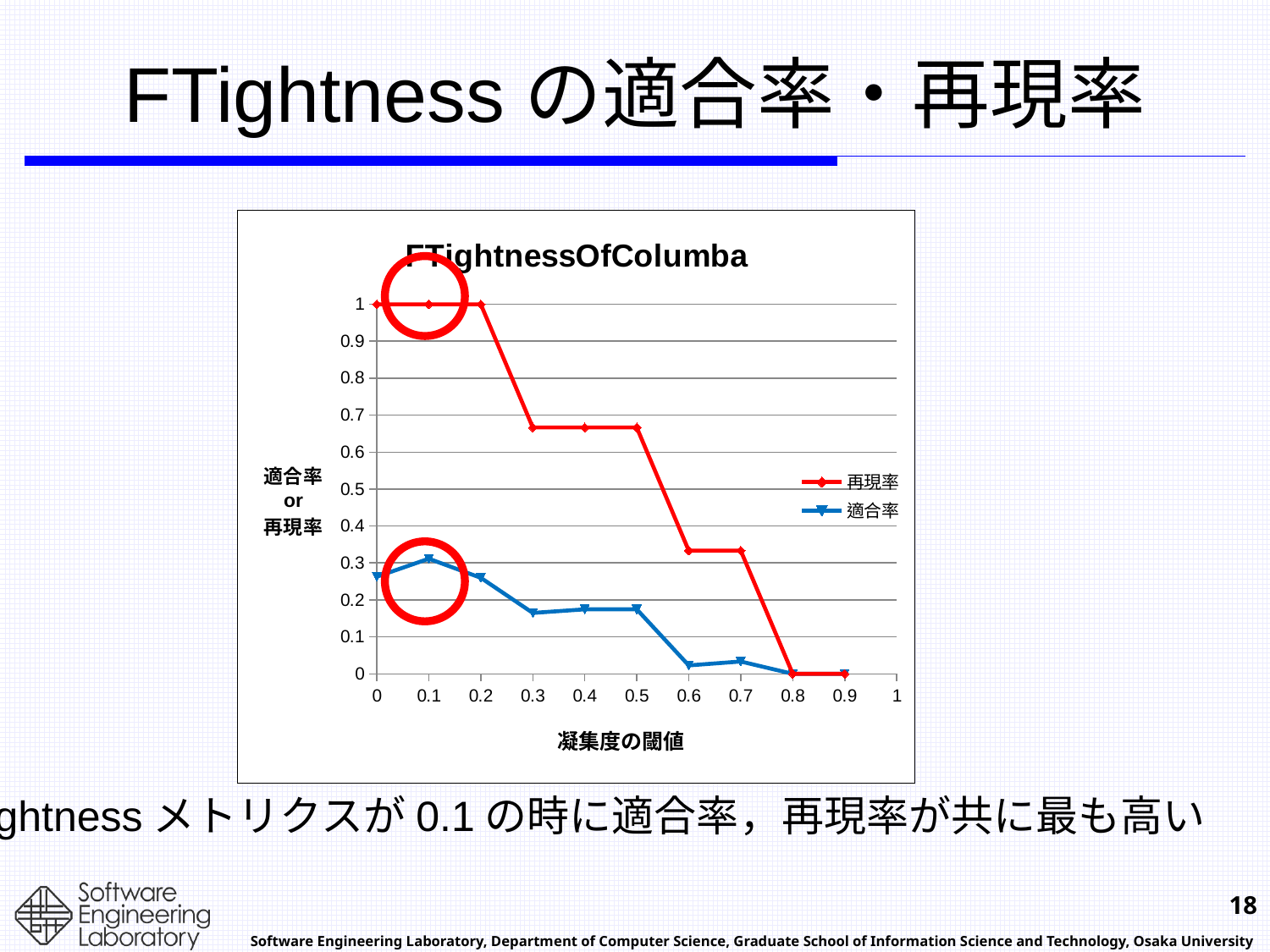
Is the value of 適合率 at a 凝集度の閾値 of 0.1 greater or less than 0.4? less Which series has the larger value at a 凝集度の閾値 of 0.3, 再現率 or 適合率? 再現率 What is the value of 再現率 at a 凝集度の閾値 of 0.8? 0 Is the value of 再現率 at a 凝集度の閾値 of 0.4 greater or less than 0.6? greater What is the label of the x axis? 凝集度の閾値 Is the value of 再現率 at a 凝集度の閾値 of 0.7 greater or less than 0.5? less How many series does the legend of the FTightnessOfColumba chart list? 2 Does the 再現率 series rise or fall as the 凝集度の閾値 increases? fall What type of chart is shown on the slide? line chart What is the title of the chart? FTightnessOfColumba What is the value of 適合率 at a 凝集度の閾値 of 0.9? 0 What is the value of 再現率 at a 凝集度の閾値 of 0? 1